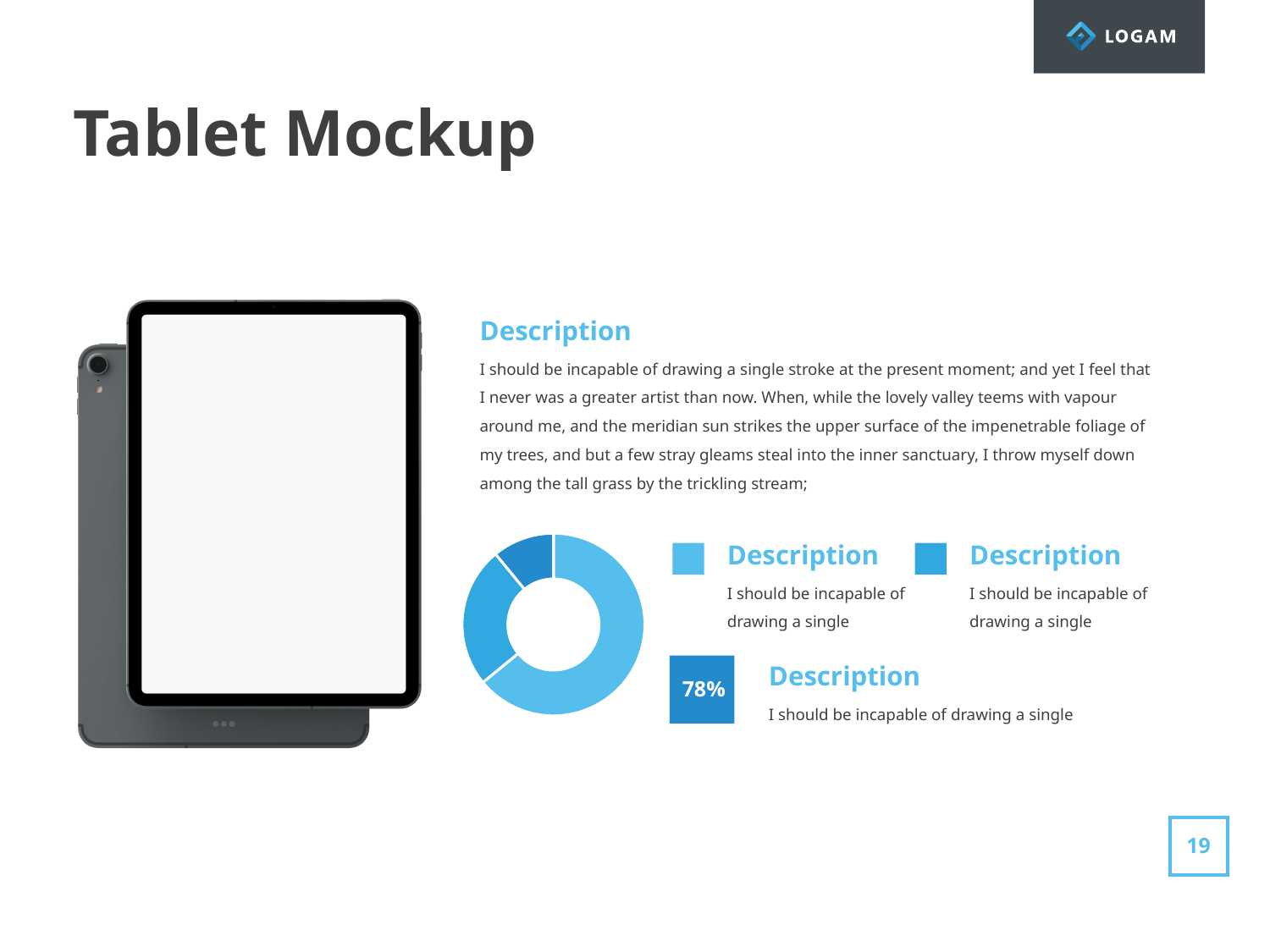
Which colour slice of the doughnut chart is the largest? light blue Does the doughnut chart display a legend? No How many slices does the doughnut chart have? 3 Does the largest slice of the doughnut chart cover more or less than half of the ring? more Which colour slice of the doughnut chart is the smallest? dark blue What kind of chart is shown on the slide? doughnut chart